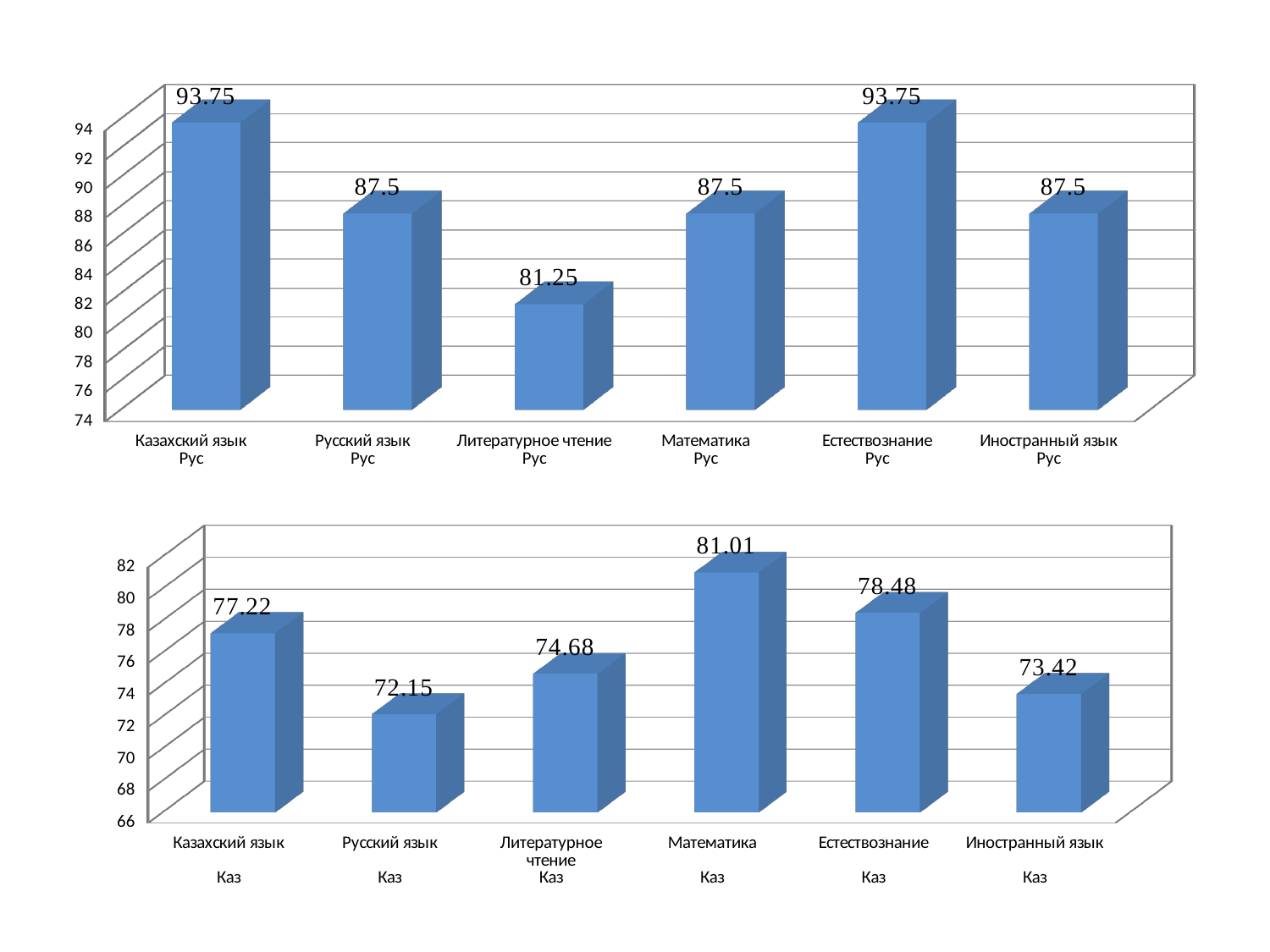
In the top chart, what is the difference between the values for Казахский язык Рус and Русский язык Рус? 6.25 In the bottom chart, what is the value for Иностранный язык Каз? 73.42 In the bottom chart, which category has the lowest value? Русский язык Каз In the top chart, which category has the lowest value? Литературное чтение Рус What type of chart is the top chart? Bar chart In the top chart, what is the value for Литературное чтение Рус? 81.25 In the top chart, what is the value for Естествознание Рус? 93.75 In the top chart, how many categories are shown? 6 In the bottom chart, what is the difference between the values for Математика Каз and Русский язык Каз? 8.86 In the bottom chart, what is the value for Математика Каз? 81.01 In the bottom chart, which is larger: the value for Казахский язык Каз or Естествознание Каз? Естествознание Каз In the bottom chart, which category has the highest value? Математика Каз